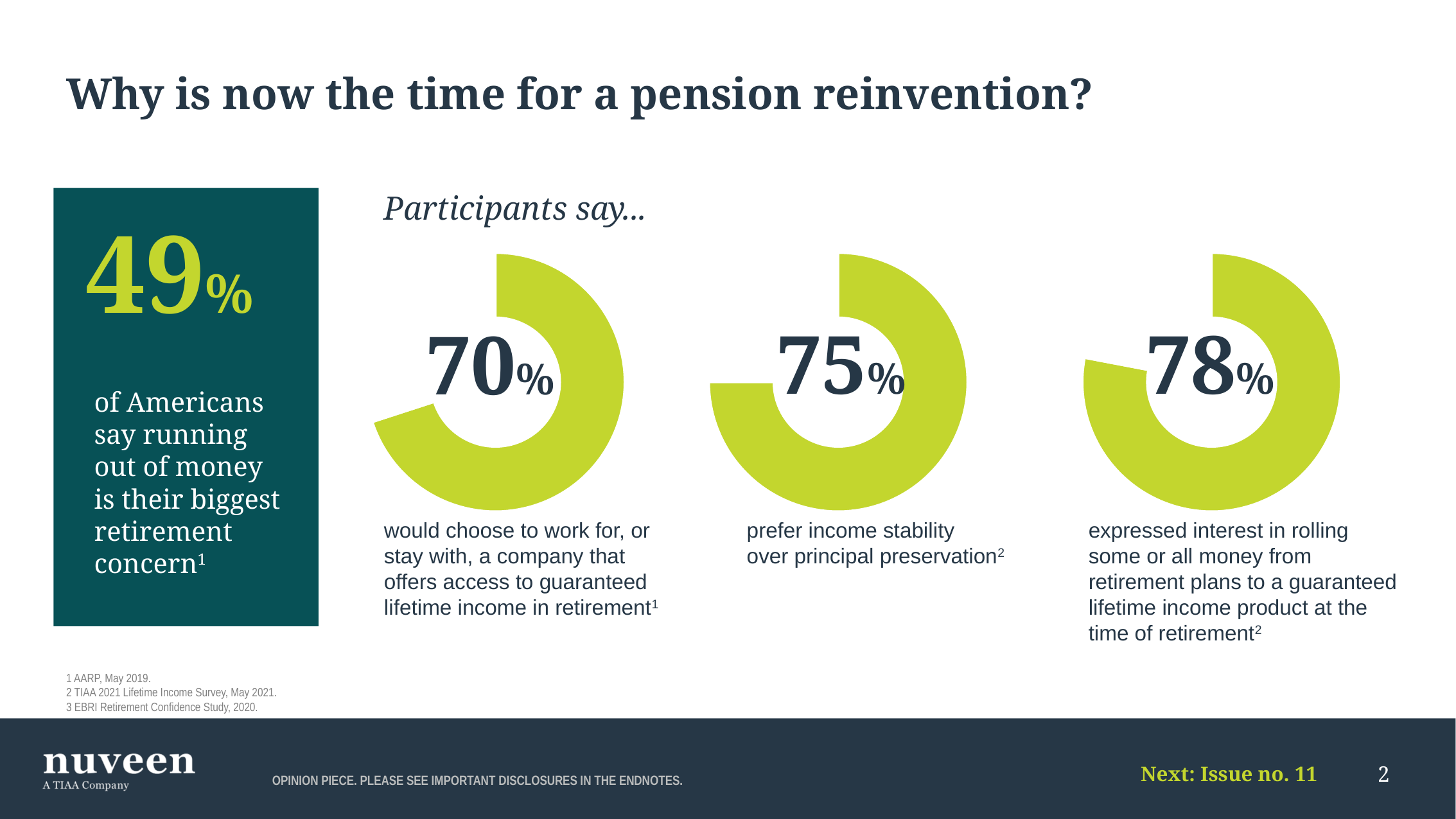
What is the difference between the middle donut chart value and the left donut chart value? 5 percentage points What type of chart is used to display the 70%, 75% and 78% figures? Donut (pie) chart What percentage of participants prefer income stability over principal preservation, according to the middle donut chart? 75% How many donut charts are shown under the heading 'Participants say...'? 3 What percentage of participants would choose to work for, or stay with, a company that offers access to guaranteed lifetime income in retirement, according to the left donut chart? 70% Which of the three donut charts under 'Participants say...' shows the lowest percentage? 70% (would work for a company offering guaranteed lifetime income) Which of the three donut charts under 'Participants say...' shows the highest percentage? 78% (rolling money to a guaranteed lifetime income product) What colour is the filled portion of the donut charts on the slide? Lime green What is the difference between the percentage in the right donut chart (78%) and the left donut chart (70%)? 8 percentage points What percentage of participants expressed interest in rolling some or all money from retirement plans to a guaranteed lifetime income product at the time of retirement, according to the right donut chart? 78% What is the heading above the three donut charts? Participants say... Which is larger: the percentage preferring income stability over principal preservation, or the percentage interested in rolling money to a guaranteed lifetime income product? Rolling money to a guaranteed lifetime income product (78%)